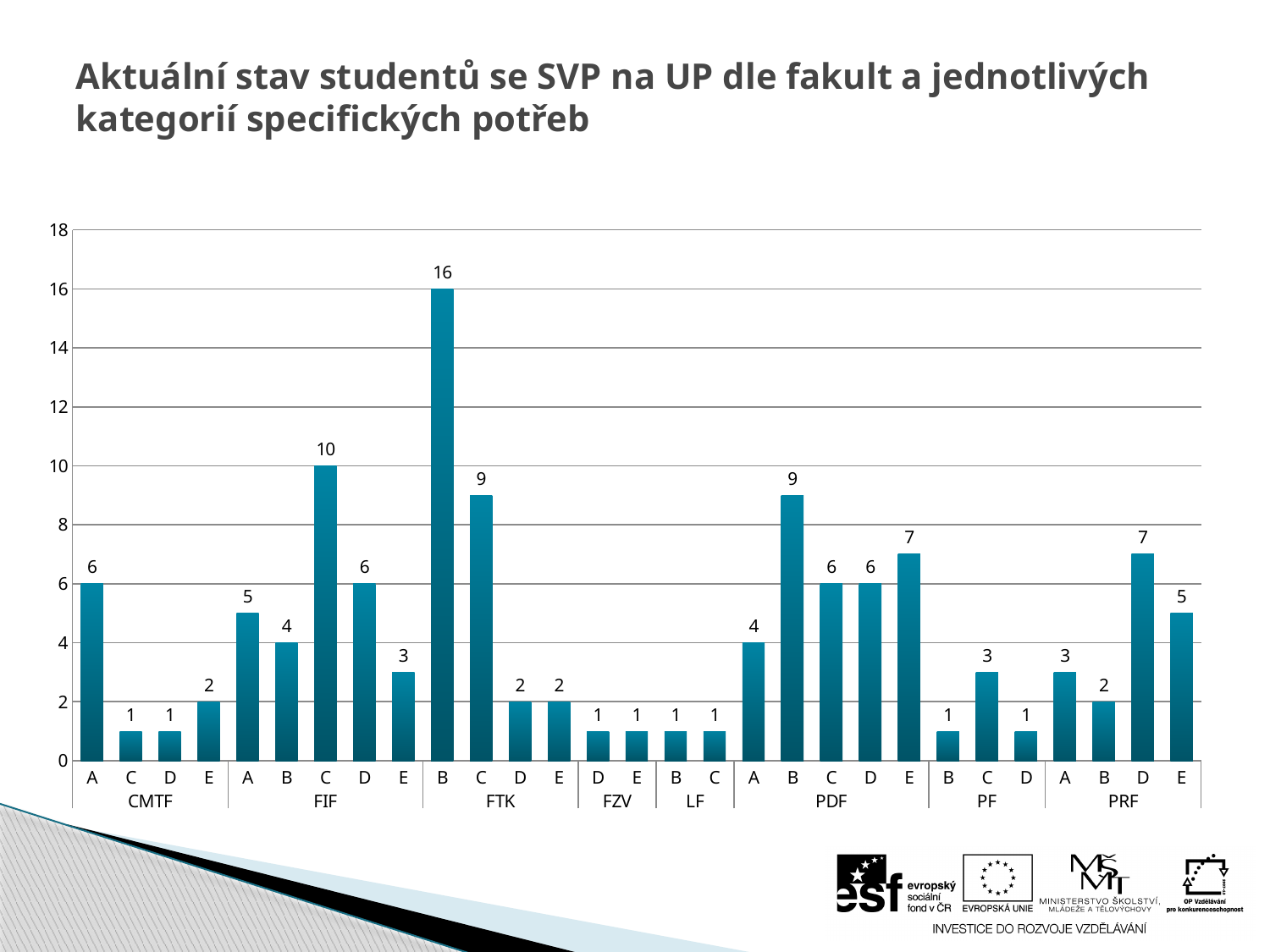
Is the value for B in FTK greater or less than 14? greater What is the value for category D in the PRF group? 7 How many bars are plotted on the chart? 29 Which is larger: the value for B in PDF or the value for E in PDF? B in PDF How many faculty groups are shown on the x axis? 8 What is the value for category B in the FTK group? 16 What is the value for category C in the FIF group? 10 What is the difference between the value for B in FTK and the value for C in FIF? 6 Which bar has the highest value on the chart? B in FTK What is the title of the slide? Aktuální stav studentů se SVP na UP dle fakult a jednotlivých kategorií specifických potřeb What kind of chart is shown on the slide? bar chart What is the total of all the values in the PDF group? 32